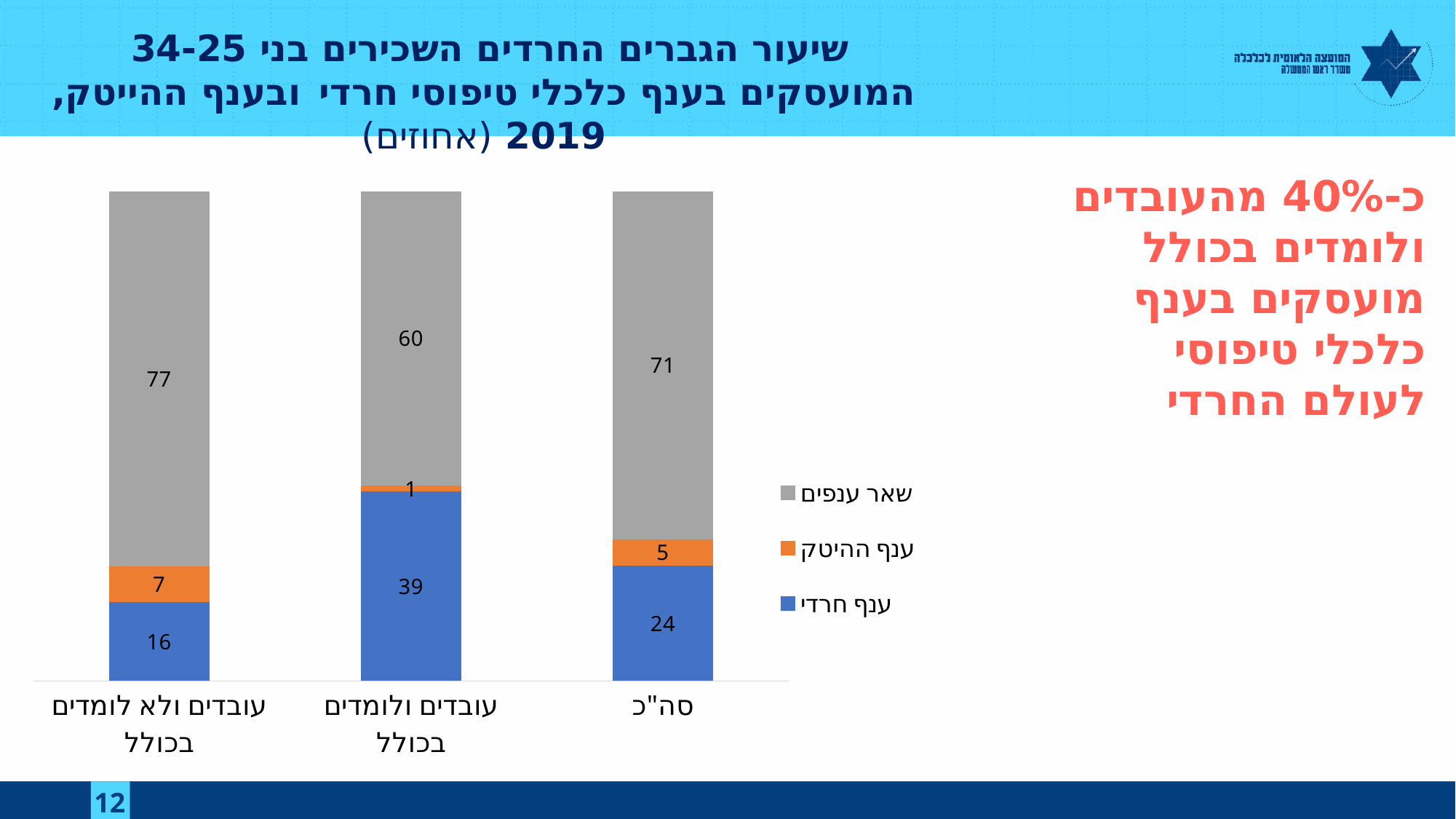
How many series does the legend list? 3 Which colour represents ענף ההיטק in the legend? orange What is the value of שאר ענפים for the category עובדים ולומדים בכולל? 60 Which category has the highest value for ענף חרדי? עובדים ולומדים בכולל How many categories are shown on the x axis? 3 What is the difference between the ענף חרדי values for עובדים ולומדים בכולל and עובדים ולא לומדים בכולל? 23 Which is larger: the שאר ענפים value for סה"כ or for עובדים ולא לומדים בכולל? עובדים ולא לומדים בכולל What is the total of the stacked bar for סה"כ? 100 What is the value of ענף ההיטק for the category עובדים ולא לומדים בכולל? 7 Which category has the lowest value for ענף ההיטק? עובדים ולומדים בכולל What type of chart is shown on the slide? stacked bar chart What is the value of ענף חרדי for the category סה"כ? 24